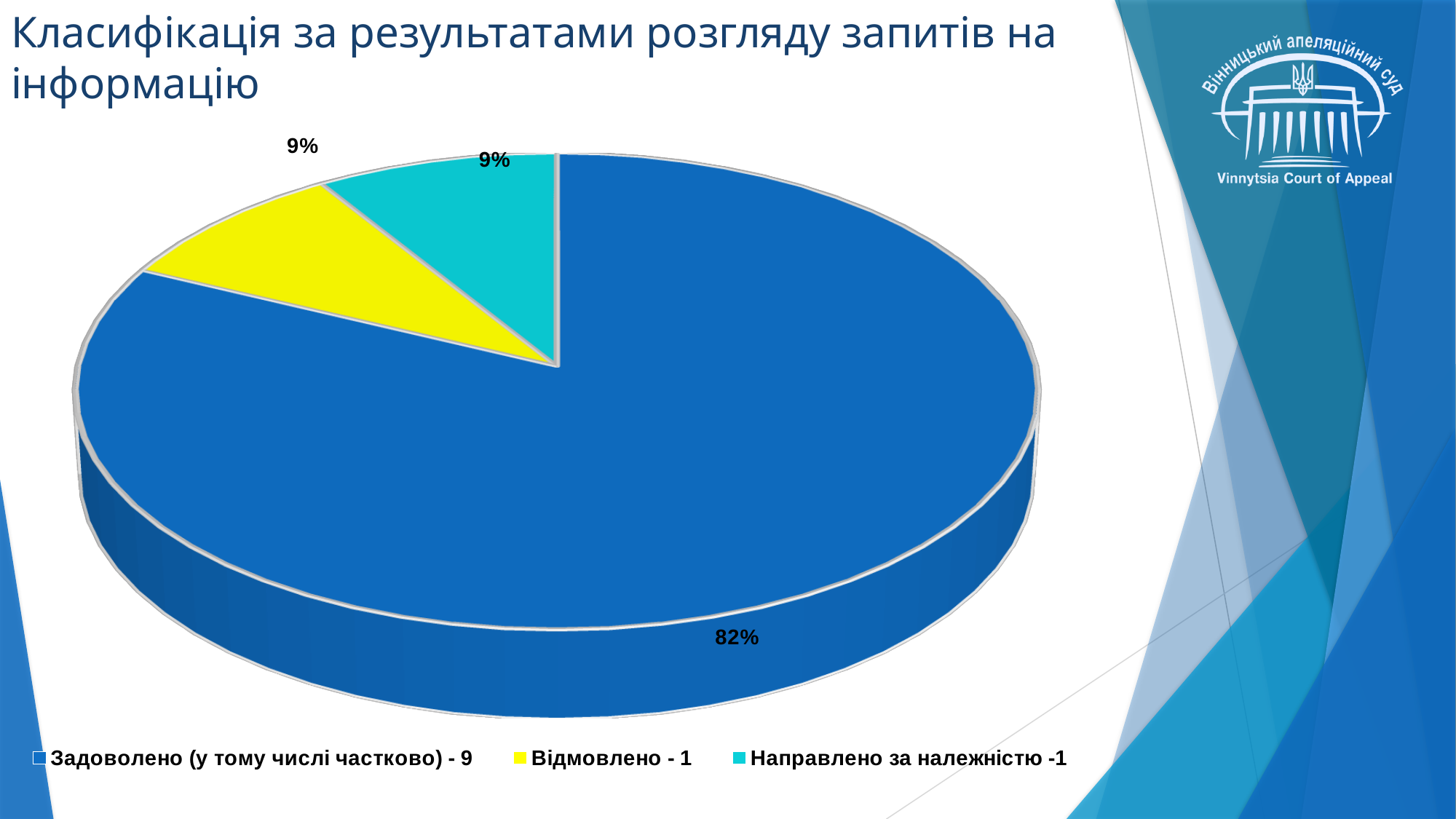
What colour is the "Відмовлено" slice in the pie chart? yellow What percentage is shown for the "Відмовлено" slice? 9% How many entries does the legend list? 3 According to the legend, how many requests were "Відмовлено"? 1 Which is larger: the slice for "Задоволено (у тому числі частково)" or the slice for "Відмовлено"? Задоволено (у тому числі частково) Which category has the largest slice of the pie? Задоволено (у тому числі частково) What is the title of the slide containing the chart? Класифікація за результатами розгляду запитів на інформацію What is the difference in percentage points between the "Задоволено (у тому числі частково)" slice and the "Відмовлено" slice? 73 percentage points What share of the pie is labelled for "Задоволено (у тому числі частково)"? 82% How many slices does the pie chart have? 3 What kind of chart is shown on the slide? pie chart What percentage is shown for the "Направлено за належністю" slice? 9%